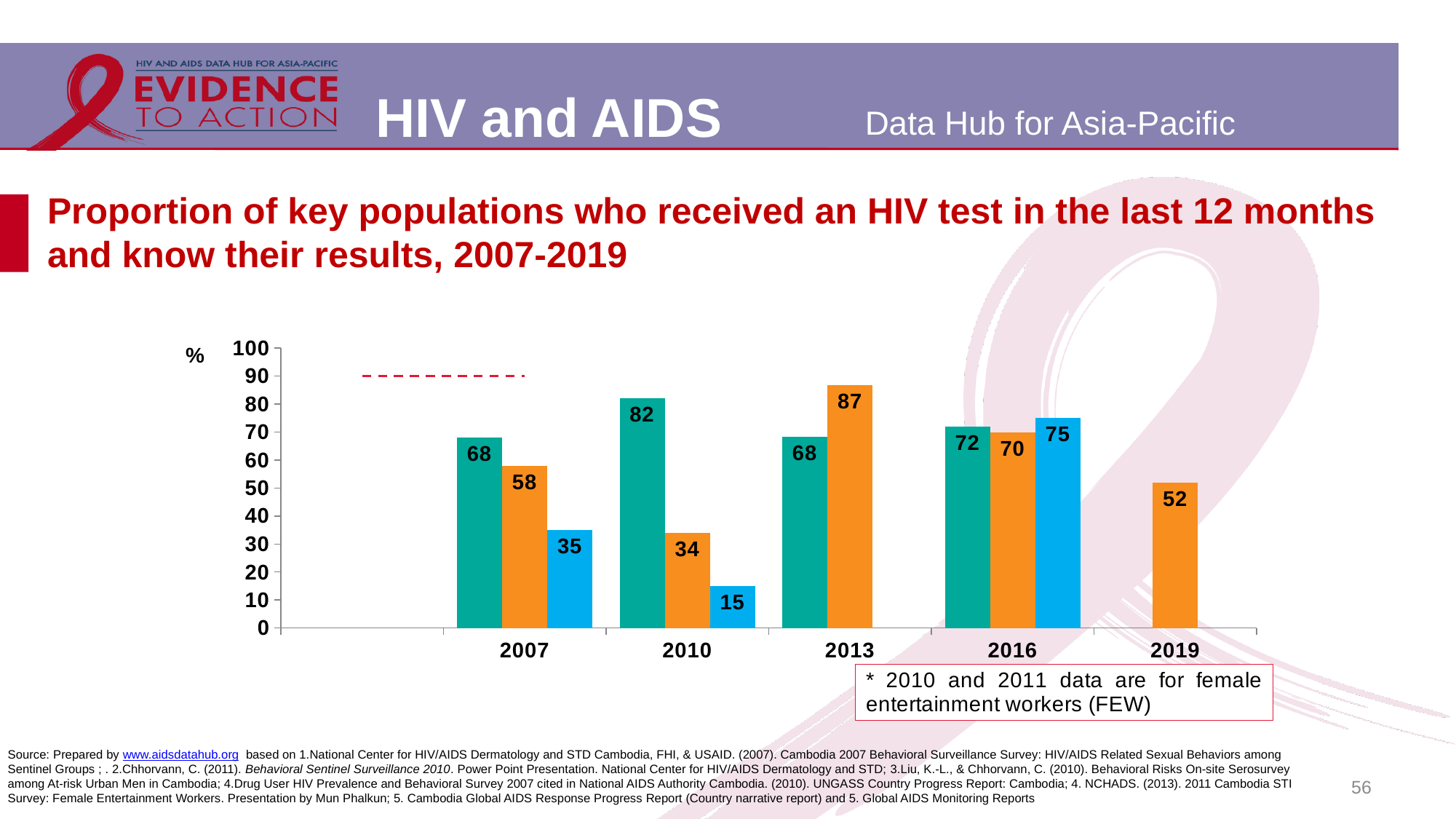
What is the difference between the teal bar and the blue bar for 2007? 33 How many bars are shown for 2019? 1 Which bar has the highest value in the chart, and what is it? The orange bar for 2013, 87 What is the value of the orange bar for 2019? 52 What is the value of the teal bar for 2010? 82 What kind of chart is shown on the slide? bar chart For 2016, which is larger: the blue bar or the orange bar? The blue bar (75) Do the orange bars rise or fall from 2013 to 2019? fall What is the value of the blue bar for 2016? 75 Which bar has the lowest value in the chart, and what is it? The blue bar for 2010, 15 What unit is shown on the y axis of the chart? % How many years are shown on the x axis of the chart? 5